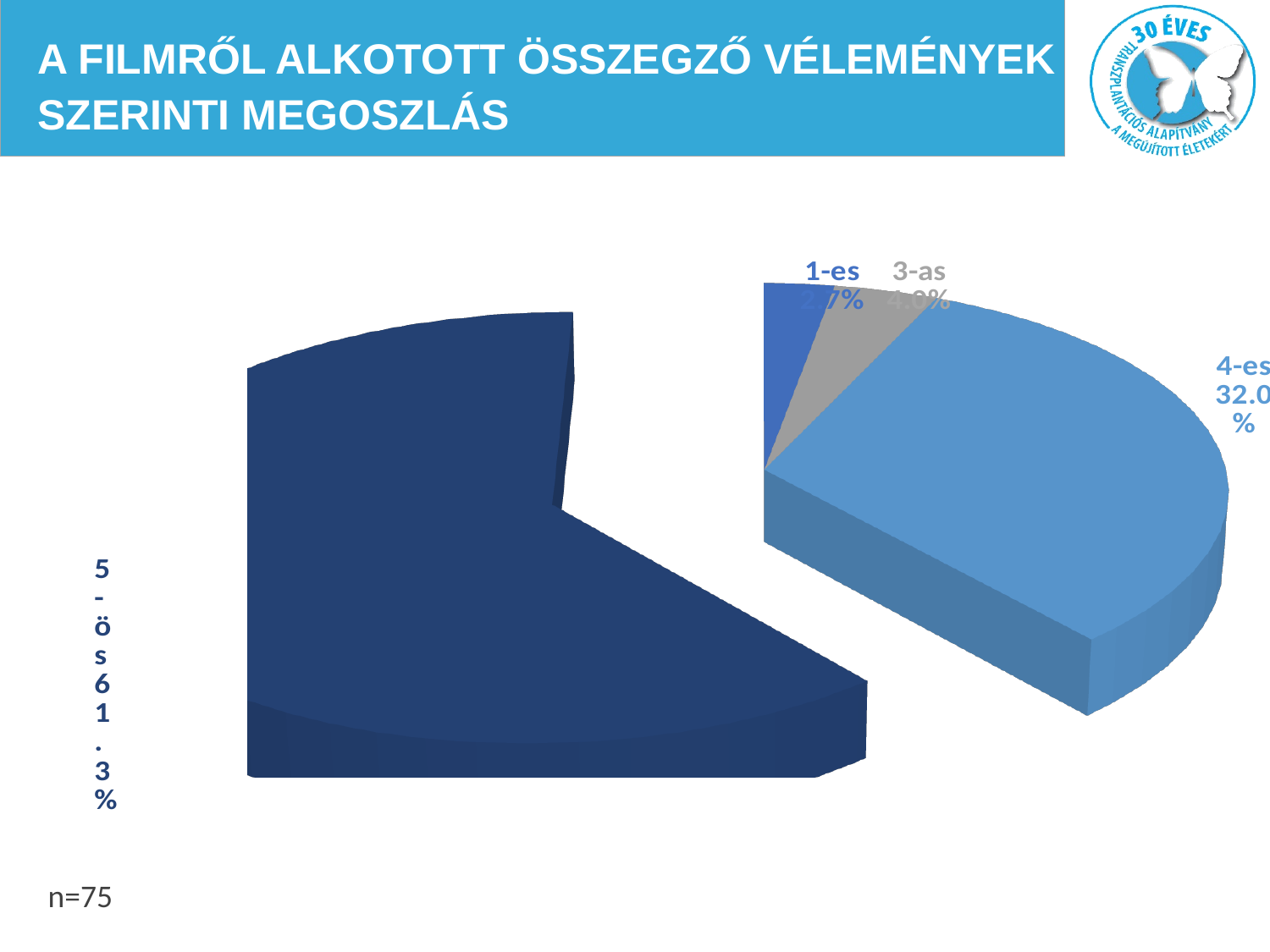
What is the title of the slide containing the pie chart? A FILMRŐL ALKOTOTT ÖSSZEGZŐ VÉLEMÉNYEK SZERINTI MEGOSZLÁS Which category has the largest slice of the pie? 5-ös What sample size (n) is stated on the slide? n=75 Which slice is larger, "4-es" or "3-as"? 4-es What share of the pie does the "5-ös" slice represent? 61.3% What share of the pie does the "4-es" slice represent? 32.0% What is the difference in percentage points between the "5-ös" and "4-es" slices? 29.3 percentage points How many slices does the pie chart have? 4 What is the difference in percentage points between the "4-es" and "3-as" slices? 28.0 percentage points Which slice is larger, "5-ös" or "4-es"? 5-ös What kind of chart is shown on the slide? pie chart What share of the pie does the "3-as" slice represent? 4.0%